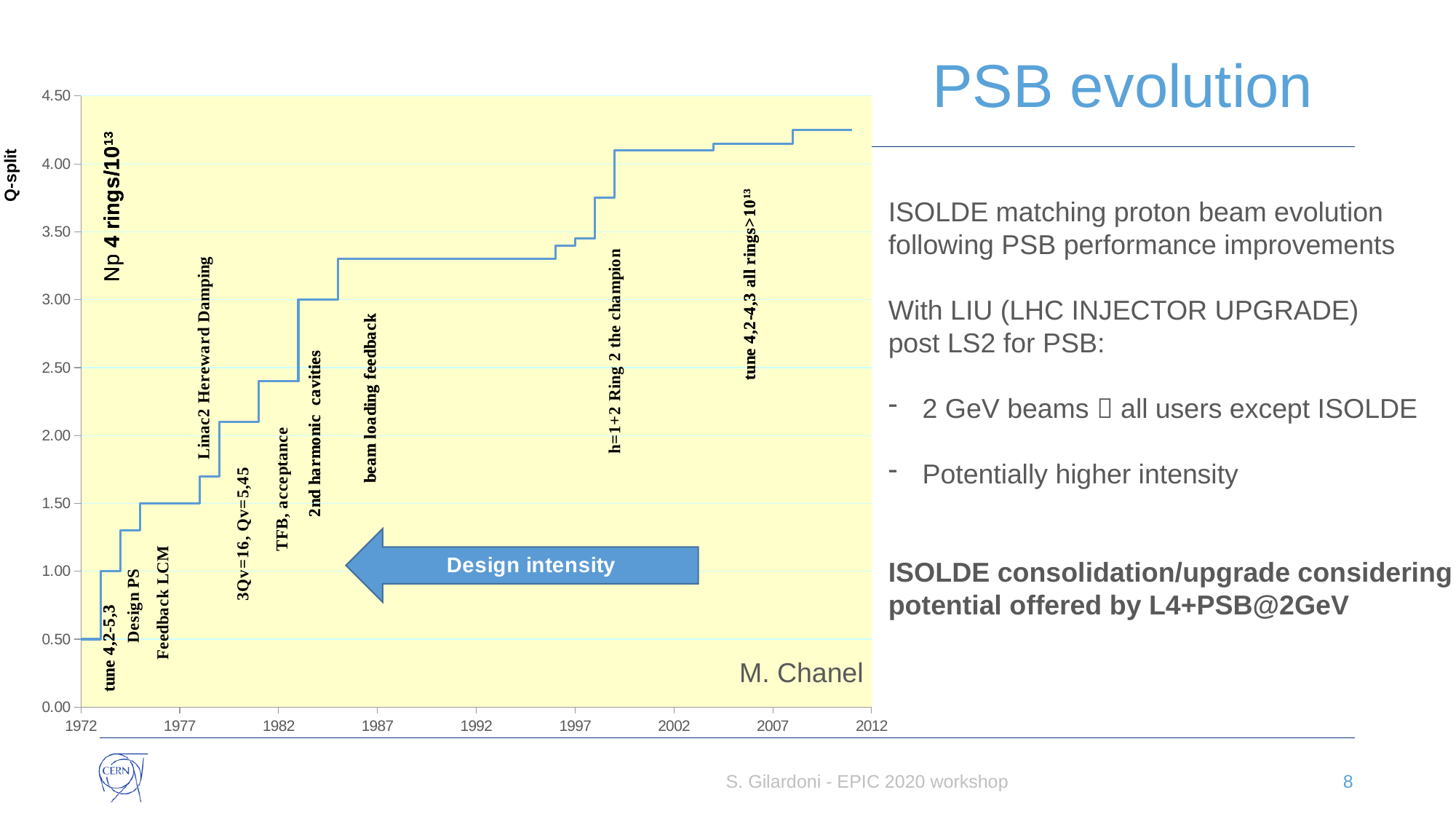
What text is written inside the blue arrow on the chart? Design intensity What value does the line start at in 1972? 0.50 What kind of chart is shown on the slide? line chart Do the plotted values rise or fall from 1972 to 2012? rise Is the value in 1987 greater or less than 3.00? greater Which year has the larger value, 1977 or 1987? 1987 What is the last year shown on the x axis? 2012 In which year shown on the x axis is the plotted value lowest? 1972 Is the value in 1992 greater or less than 3.50? less Is the value in 2012 greater or less than 4.00? greater What value does the line sit at in 1977? 1.50